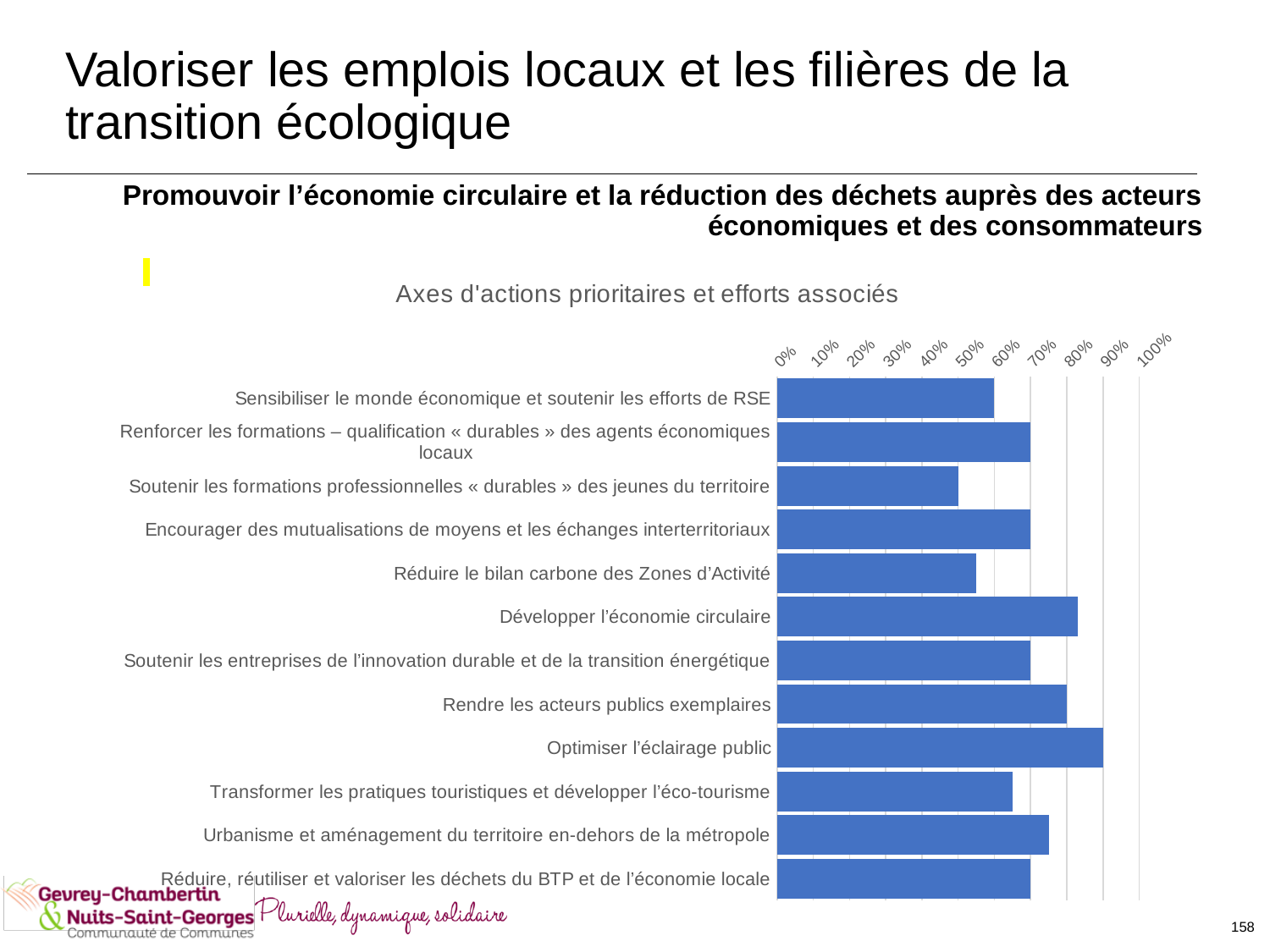
What type of chart is shown on the slide? Bar chart What colour are the bars in the chart? Blue Is the value for 'Optimiser l'éclairage public' greater or less than 80%? greater Which has a larger value: 'Développer l'économie circulaire' or 'Sensibiliser le monde économique et soutenir les efforts de RSE'? Développer l'économie circulaire Which category has the highest value in the chart? Optimiser l'éclairage public Which has a larger value: 'Optimiser l'éclairage public' or 'Réduire le bilan carbone des Zones d'Activité'? Optimiser l'éclairage public Is the value for 'Soutenir les formations professionnelles « durables » des jeunes du territoire' greater or less than 60%? less Which category has the lowest value in the chart? Soutenir les formations professionnelles « durables » des jeunes du territoire What is the title of the chart? Axes d'actions prioritaires et efforts associés Is the value for 'Développer l'économie circulaire' greater or less than 70%? greater How many action categories are plotted in the chart? 12